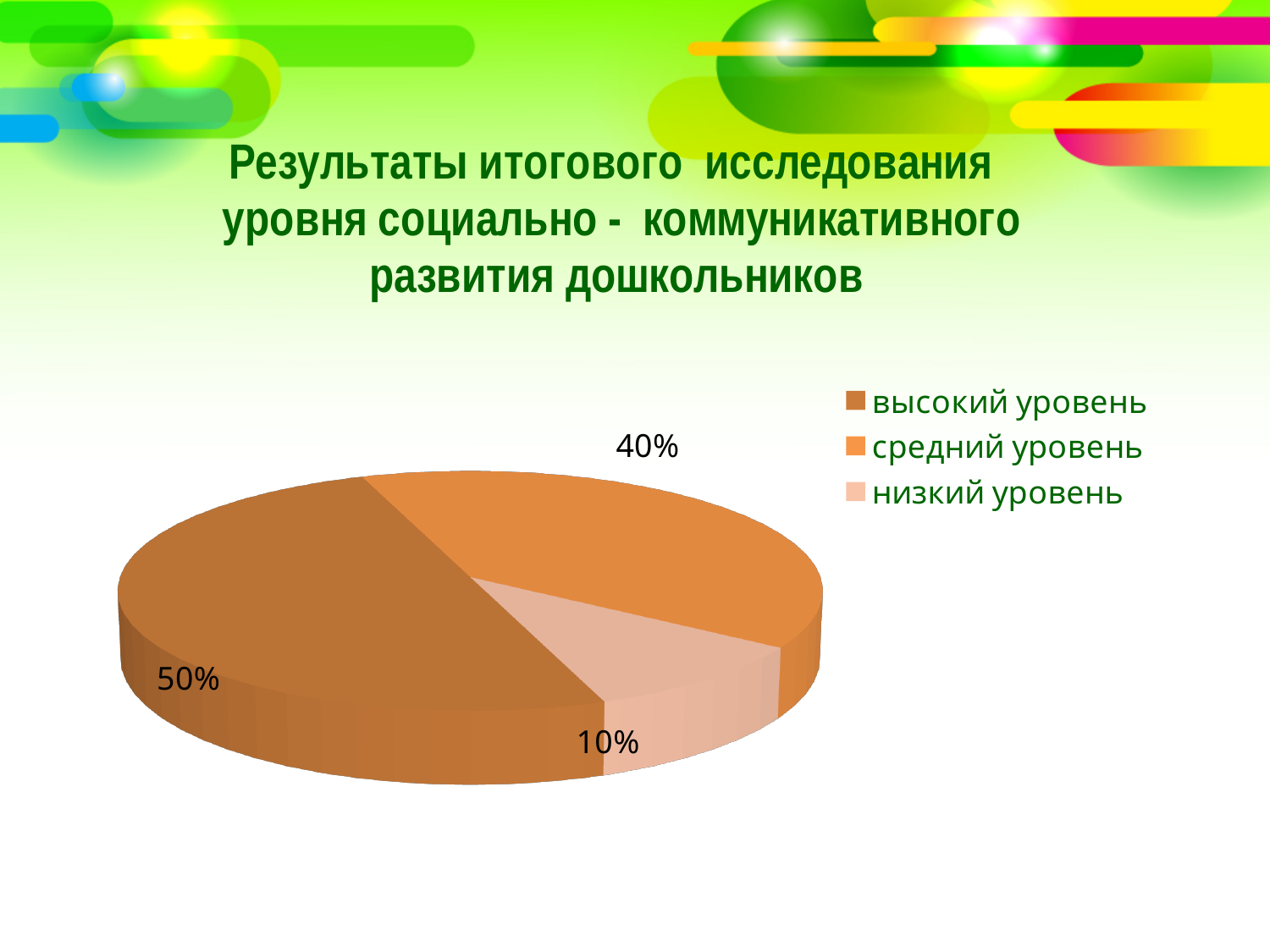
What kind of chart is shown on the slide? pie chart What share of the pie does "низкий уровень" have? 10% What is the difference between the shares of "средний уровень" and "низкий уровень"? 30% Which category has the largest slice of the pie? высокий уровень What is the title of the slide containing the chart? Результаты итогового исследования уровня социально - коммуникативного развития дошкольников What share of the pie does "высокий уровень" have? 50% What is the difference between the shares of "высокий уровень" and "низкий уровень"? 40% Which is larger, the share of "высокий уровень" or "средний уровень"? высокий уровень Which category has the smallest slice of the pie? низкий уровень What share of the pie does "средний уровень" have? 40% How many categories does the pie chart have? 3 How many entries does the legend list? 3